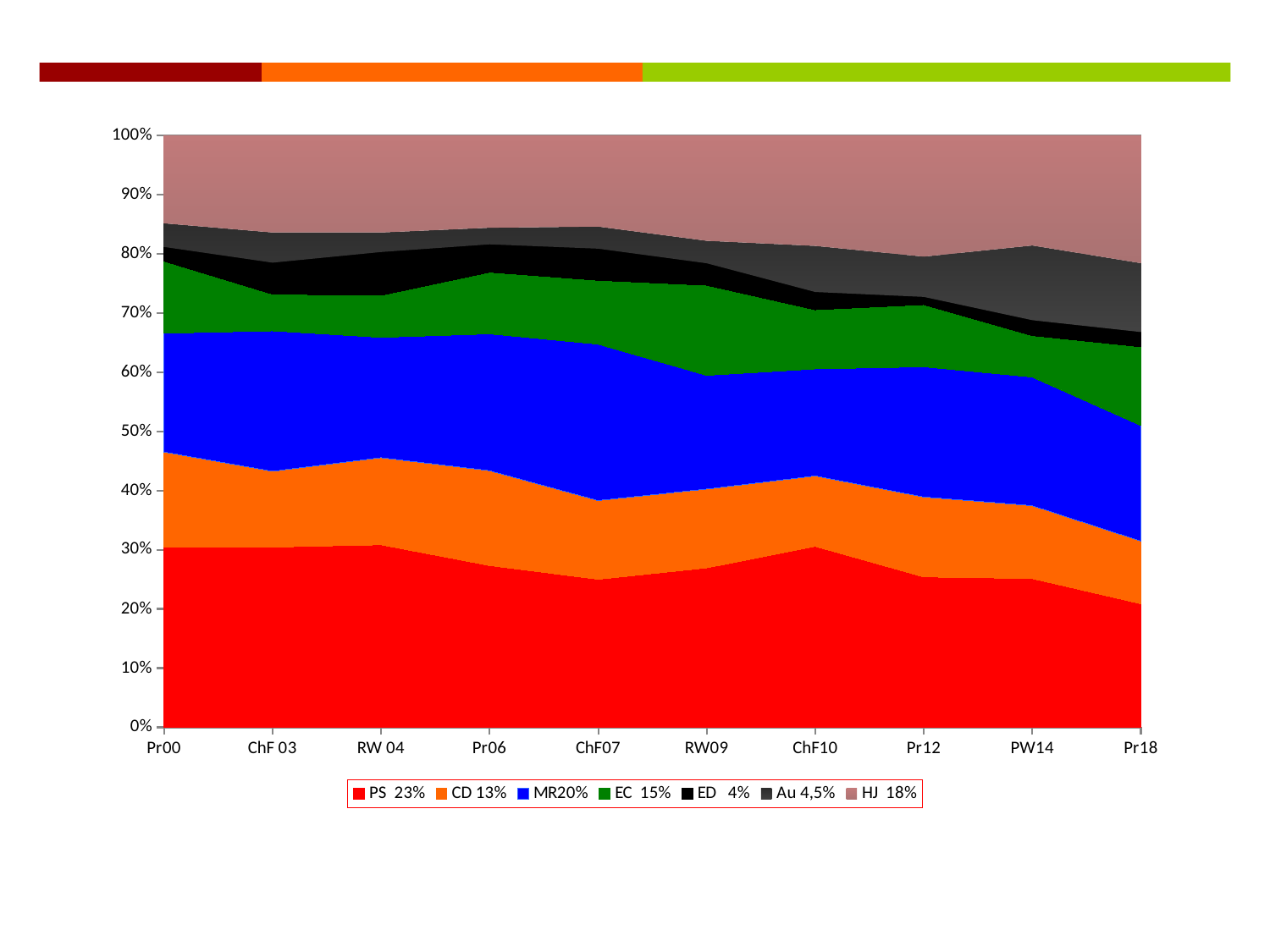
How many categories are shown along the x axis? 10 What kind of chart is shown on the slide? Stacked area chart What percentage is shown next to HJ in the legend? 18% Is the value for PS at Pr00 greater or less than 20%? greater How many series does the legend list? 7 Is the value for PS at Pr12 greater or less than 20%? greater Is the value for PS larger at Pr00 or at Pr18? Pr00 Does the PS series rise or fall overall from Pr00 to Pr18? Fall What is the first category on the x axis? Pr00 At which category is the PS series lowest? Pr18 Is the value for PS at ChF07 greater or less than 30%? less